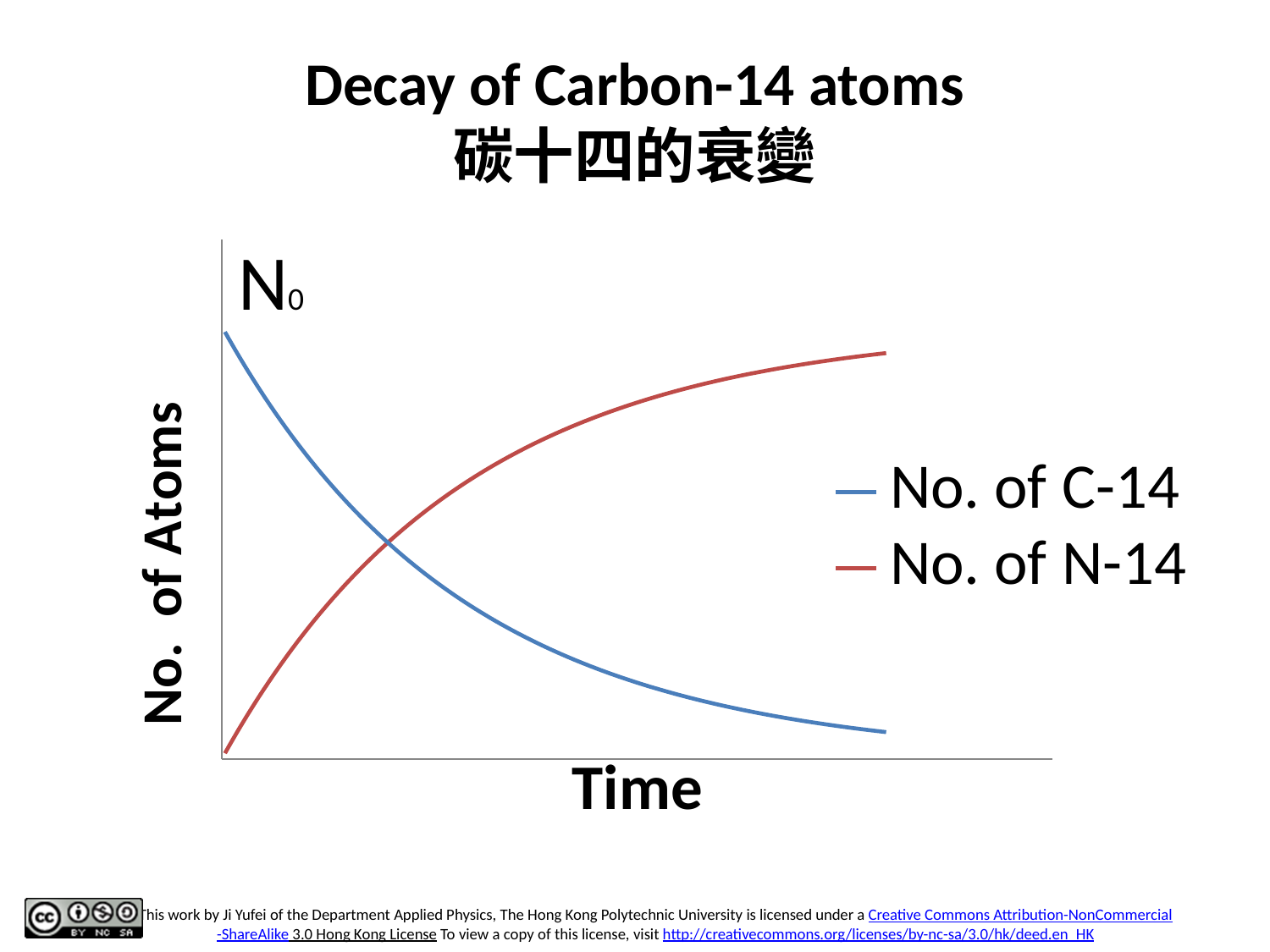
Does the No. of C-14 series rise or fall as time increases? fall What is the English title of the chart on the slide? Decay of Carbon-14 atoms Which series has the higher value at the start of the time axis, No. of C-14 or No. of N-14? No. of C-14 What colour is the line for No. of N-14? red What colour is the line for No. of C-14? blue What kind of chart is shown on the slide? line chart Does the No. of N-14 series rise or fall as time increases? rise How many series does the legend list? 2 Which series has the higher value at the end of the time axis, No. of C-14 or No. of N-14? No. of N-14